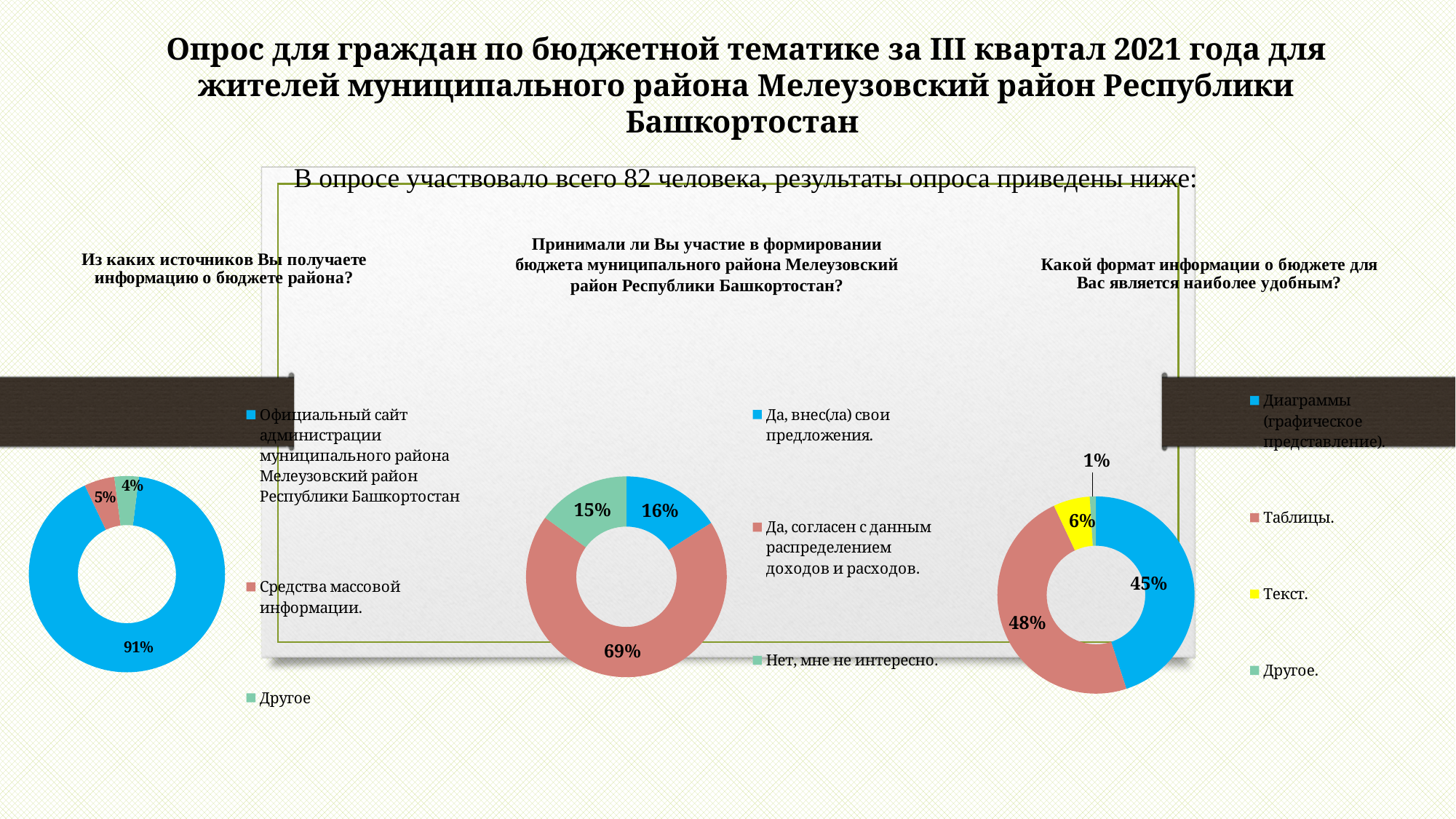
In the left chart, which category has the smallest share? Другое In the right chart, which category has the largest share? Таблицы In the middle chart, what is the difference between the share for "Да, согласен с данным распределением доходов и расходов" and the share for "Да, внес(ла) свои предложения"? 53% In the middle chart, what share is shown for "Нет, мне не интересно"? 15% In the left chart ("Из каких источников Вы получаете информацию о бюджете района?"), what share is labelled for "Официальный сайт администрации муниципального района Мелеузовский район Республики Башкортостан"? 91% What type of chart is used for the three charts on the slide? Doughnut chart In the middle chart ("Принимали ли Вы участие в формировании бюджета..."), what share is shown for "Да, согласен с данным распределением доходов и расходов"? 69% In the right chart ("Какой формат информации о бюджете для Вас является наиболее удобным?"), what share is shown for "Таблицы"? 48% In the right chart, how many categories does the legend list? 4 In the right chart, what share is shown for "Текст"? 6% In the middle chart, how many categories does the legend list? 3 In the left chart, what share is shown for "Средства массовой информации"? 5%